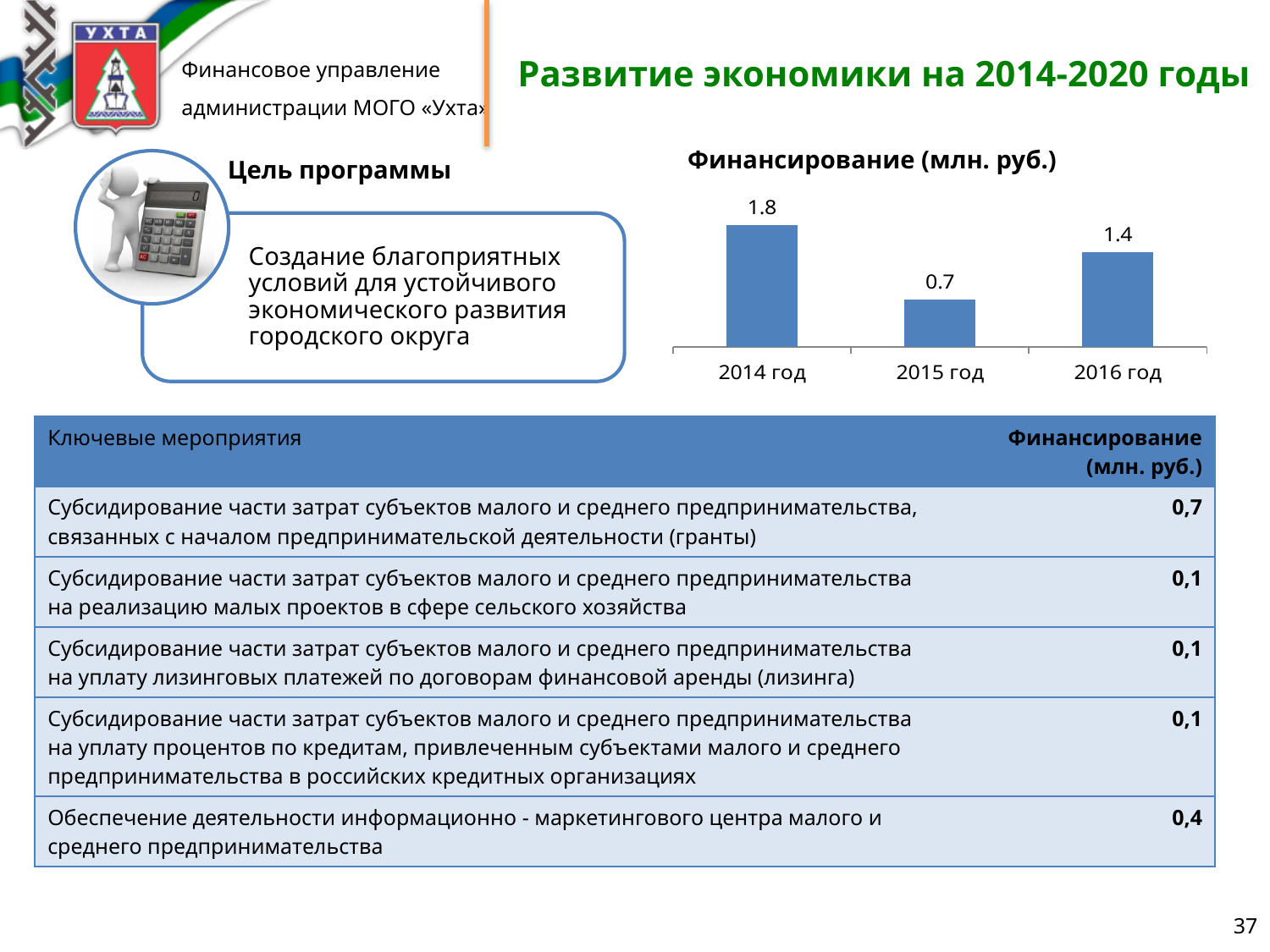
What colour are the bars in the Финансирование (млн. руб.) chart? blue What is the value for 2016 год in the Финансирование (млн. руб.) chart? 1.4 What is the value for 2014 год in the Финансирование (млн. руб.) chart? 1.8 What is the difference between the values for 2014 год and 2015 год in the Финансирование (млн. руб.) chart? 1.1 What is the difference between the values for 2016 год and 2015 год in the Финансирование (млн. руб.) chart? 0.7 What kind of chart is the Финансирование (млн. руб.) chart? bar chart How many years are shown in the Финансирование (млн. руб.) chart? 3 What is the value for 2015 год in the Финансирование (млн. руб.) chart? 0.7 What is the title of the chart on the slide? Финансирование (млн. руб.) Which year has the highest value in the Финансирование (млн. руб.) chart? 2014 год Which is larger in the Финансирование (млн. руб.) chart, the value for 2014 год or 2016 год? 2014 год Which year has the lowest value in the Финансирование (млн. руб.) chart? 2015 год